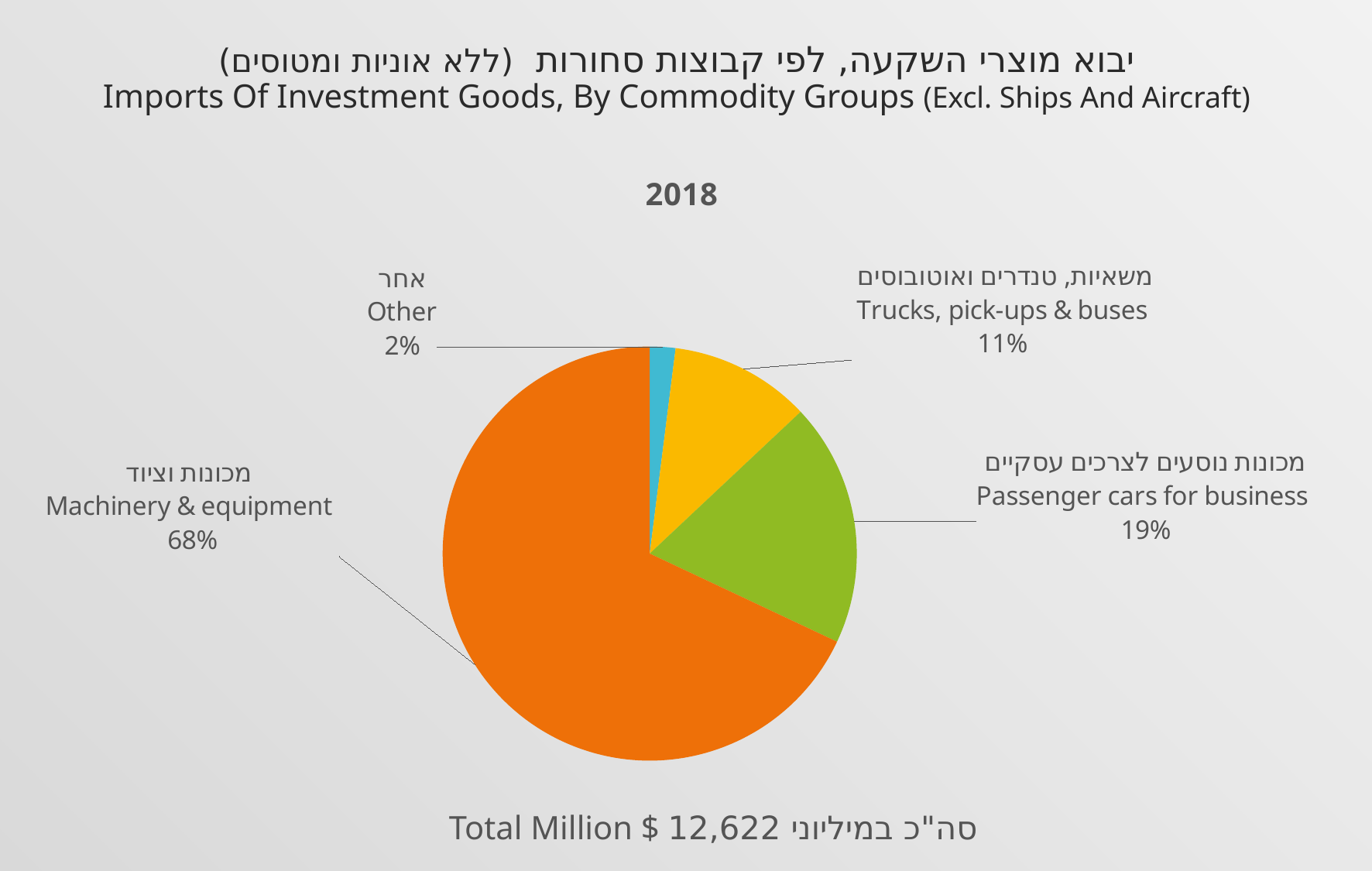
What percentage of the pie is Passenger cars for business? 19% What share of imports of investment goods in 2018 is Machinery & equipment? 68% What share does Trucks, pick-ups & buses hold in the chart? 11% What type of chart is shown on the slide? Pie chart Which is larger: the share for Trucks, pick-ups & buses or the share for Passenger cars for business? Passenger cars for business How many slices does the pie chart have? 4 What is the difference in percentage points between Machinery & equipment and Passenger cars for business? 49 What percentage is shown for the Other slice? 2% What year does the chart show data for? 2018 Which commodity group has the smallest share of the pie? Other Which commodity group has the largest share of the pie? Machinery & equipment What total in million dollars is stated below the chart? 12,622